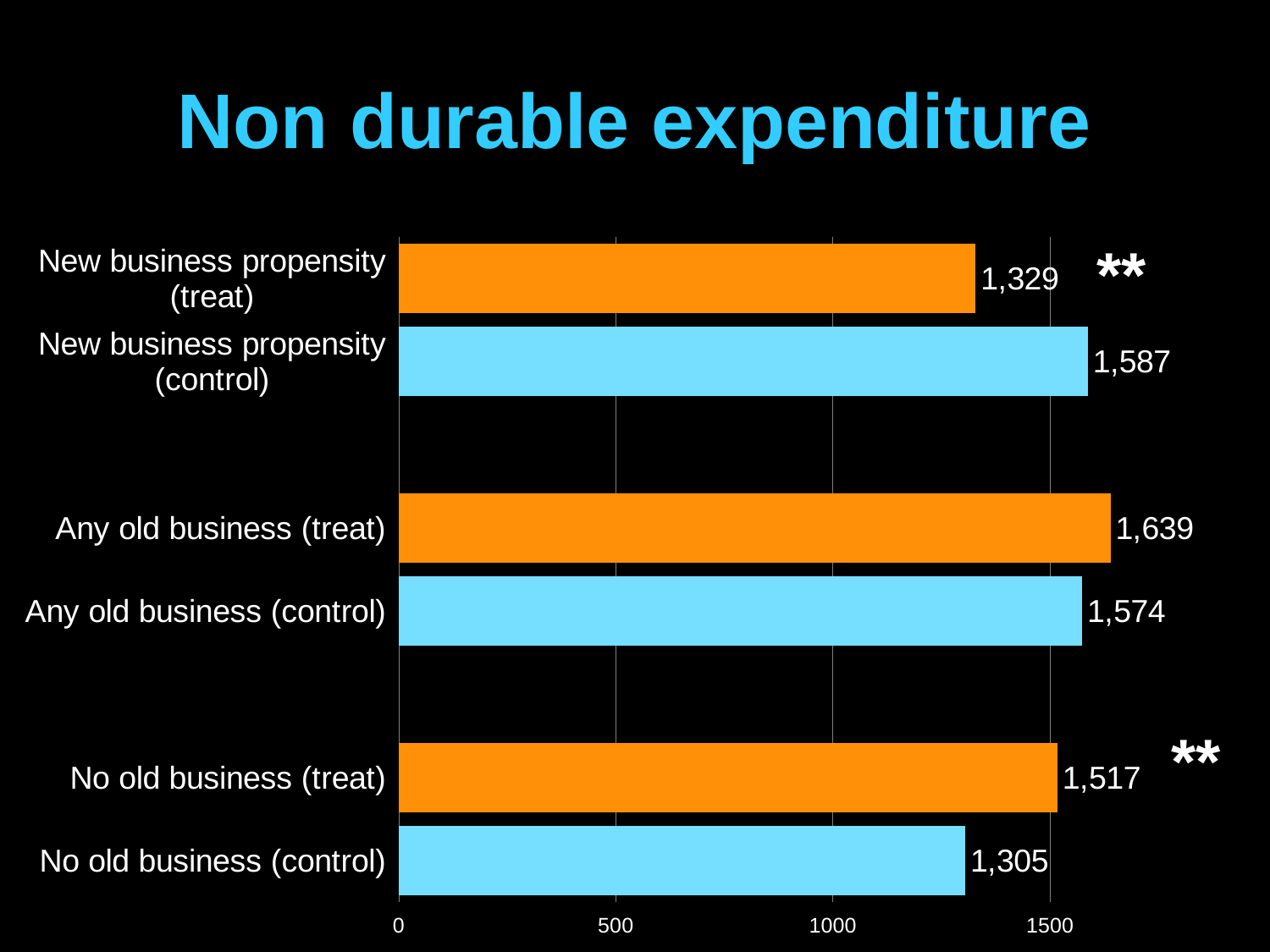
Which category has the highest value? Any old business (treat) Which category has the lowest value? No old business (control) What is the value for New business propensity (treat)? 1,329 How many bars are shown in the chart? 6 Is the value for New business propensity (treat) greater or less than 1500? less What is the title of the chart? Non durable expenditure What is the difference between No old business (treat) and No old business (control)? 212 What is the difference between New business propensity (control) and New business propensity (treat)? 258 What is the value for Any old business (control)? 1,574 What is the value for No old business (treat)? 1,517 Which is larger, Any old business (treat) or Any old business (control)? Any old business (treat) What kind of chart is shown on the slide? bar chart